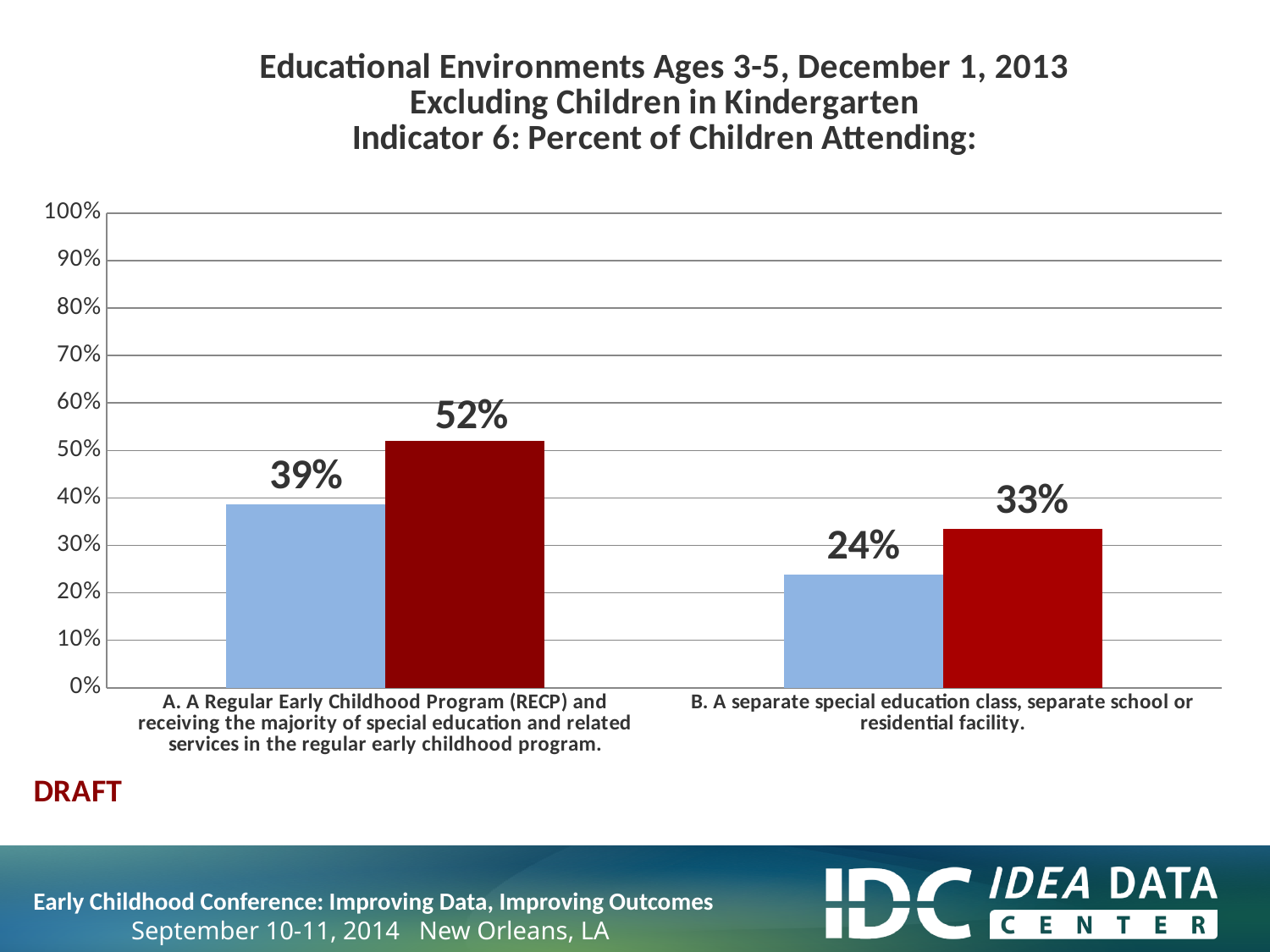
Which is larger: the light blue bar for category A or the dark red bar for category B? the light blue bar for category A (39%) Which bar has the highest value in the chart? the dark red bar for category A (52%) Which bar has the lowest value in the chart? the light blue bar for category B (24%) How many categories are shown on the x axis of the chart? 2 What is the value of the light blue bar for category A (A Regular Early Childhood Program)? 39% What is the difference between the dark red and light blue bars for category A? 13% What is the value of the light blue bar for category B (A separate special education class, separate school or residential facility)? 24% What is the value of the dark red bar for category A (A Regular Early Childhood Program)? 52% What is the title of the chart? Educational Environments Ages 3-5, December 1, 2013 Excluding Children in Kindergarten Indicator 6: Percent of Children Attending: What is the value of the dark red bar for category B (A separate special education class, separate school or residential facility)? 33% What kind of chart is shown on the slide? bar chart What is the difference between the dark red and light blue bars for category B? 9%